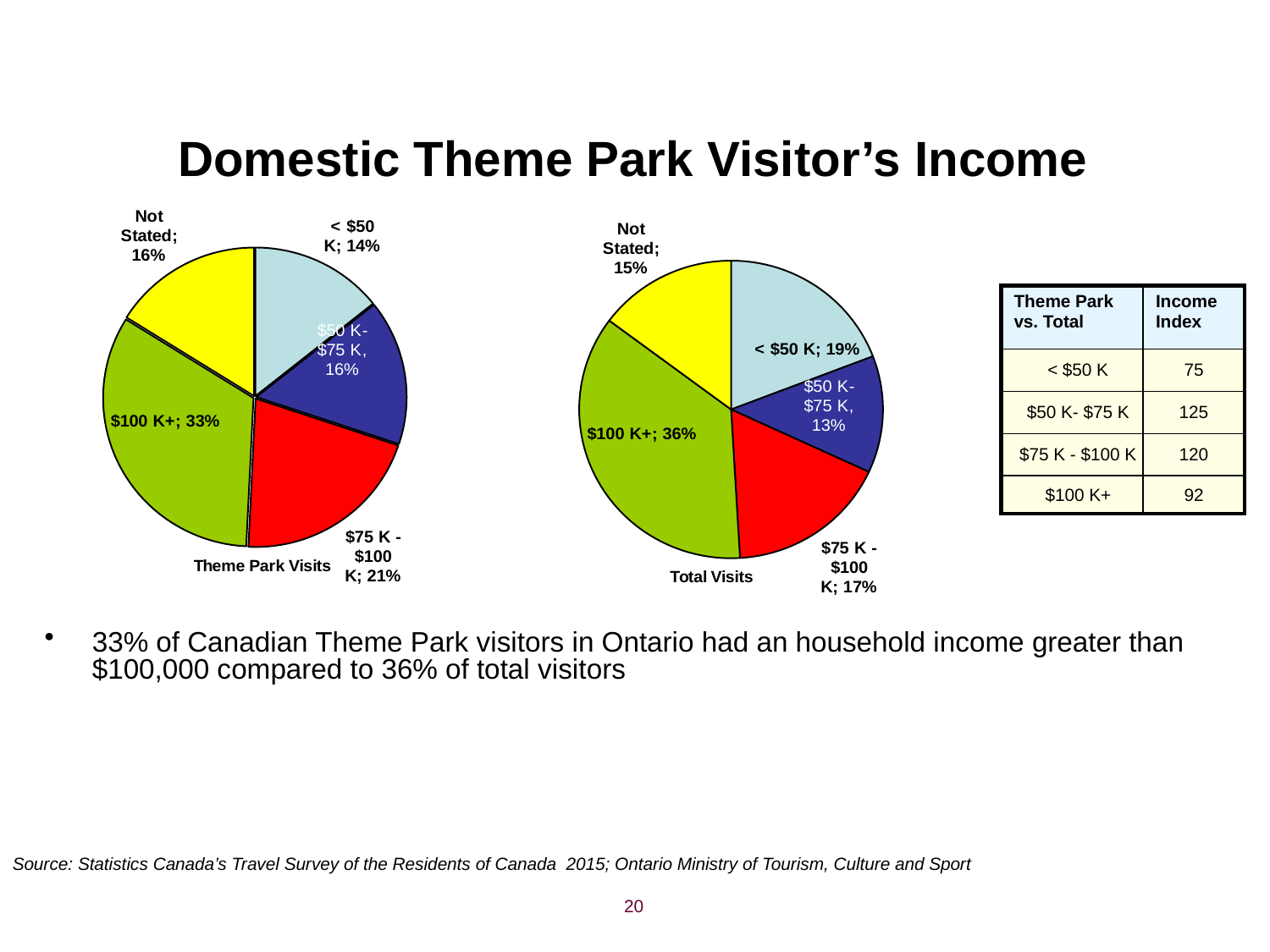
In the Total Visits pie chart, which income category has the smallest slice? $50 K-$75 K What is the difference between the $100 K+ share in the Total Visits pie chart and the $100 K+ share in the Theme Park Visits pie chart? 3 percentage points What type of chart is used to show the Total Visits income breakdown? Pie chart In the Theme Park Visits pie chart, which income category has the smallest slice? < $50 K In the Theme Park Visits pie chart, what percentage is shown for the < $50 K slice? 14% In the Total Visits pie chart, what percentage is shown for the $50 K-$75 K slice? 13% In the Theme Park Visits pie chart, what percentage is shown for the $75 K - $100 K slice? 21% In the Total Visits pie chart, which income category has the largest slice? $100 K+ In the Total Visits pie chart, what share of visitors had an income of $100 K+? 36% How many slices does the Theme Park Visits pie chart have? 5 Is the < $50 K share larger in the Theme Park Visits pie chart or the Total Visits pie chart? Total Visits In the Theme Park Visits pie chart, what share of visitors had an income of $100 K+? 33%